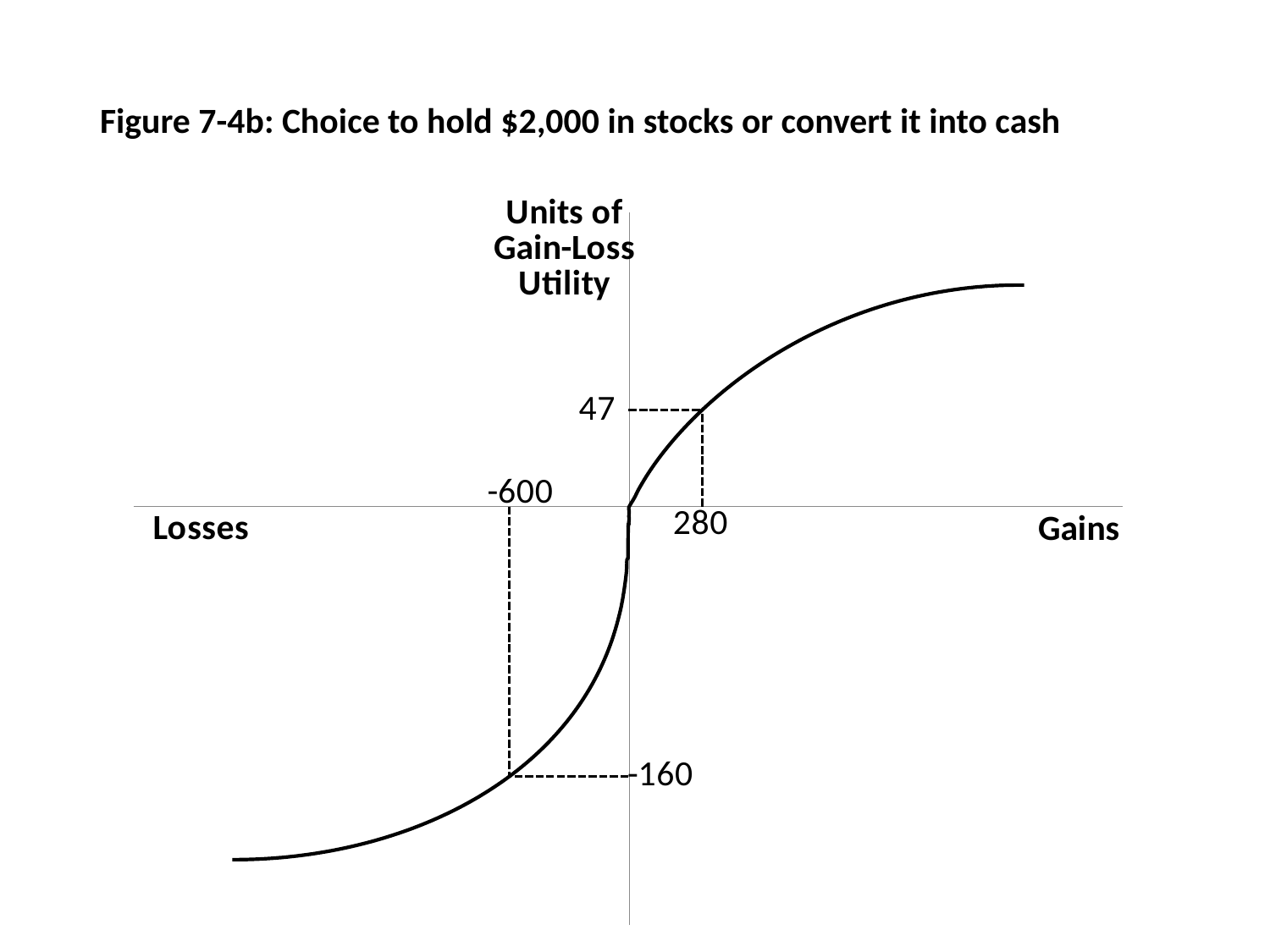
What is the label of the vertical axis? Units of Gain-Loss Utility How many points on the curve are marked with dashed lines and labeled values? 2 What kind of chart is shown on the slide? line chart What is the gain-loss utility for a gain of 280? 47 Which is larger: the utility at a gain of 280 or the utility at a loss of -600? the utility at a gain of 280 Does the curve rise or fall as you move from losses to gains along the horizontal axis? rise What is the title of the figure? Figure 7-4b: Choice to hold $2,000 in stocks or convert it into cash What is the gain-loss utility for a loss of -600? -160 What is the difference between the utility at a gain of 280 and the utility at a loss of -600? 207